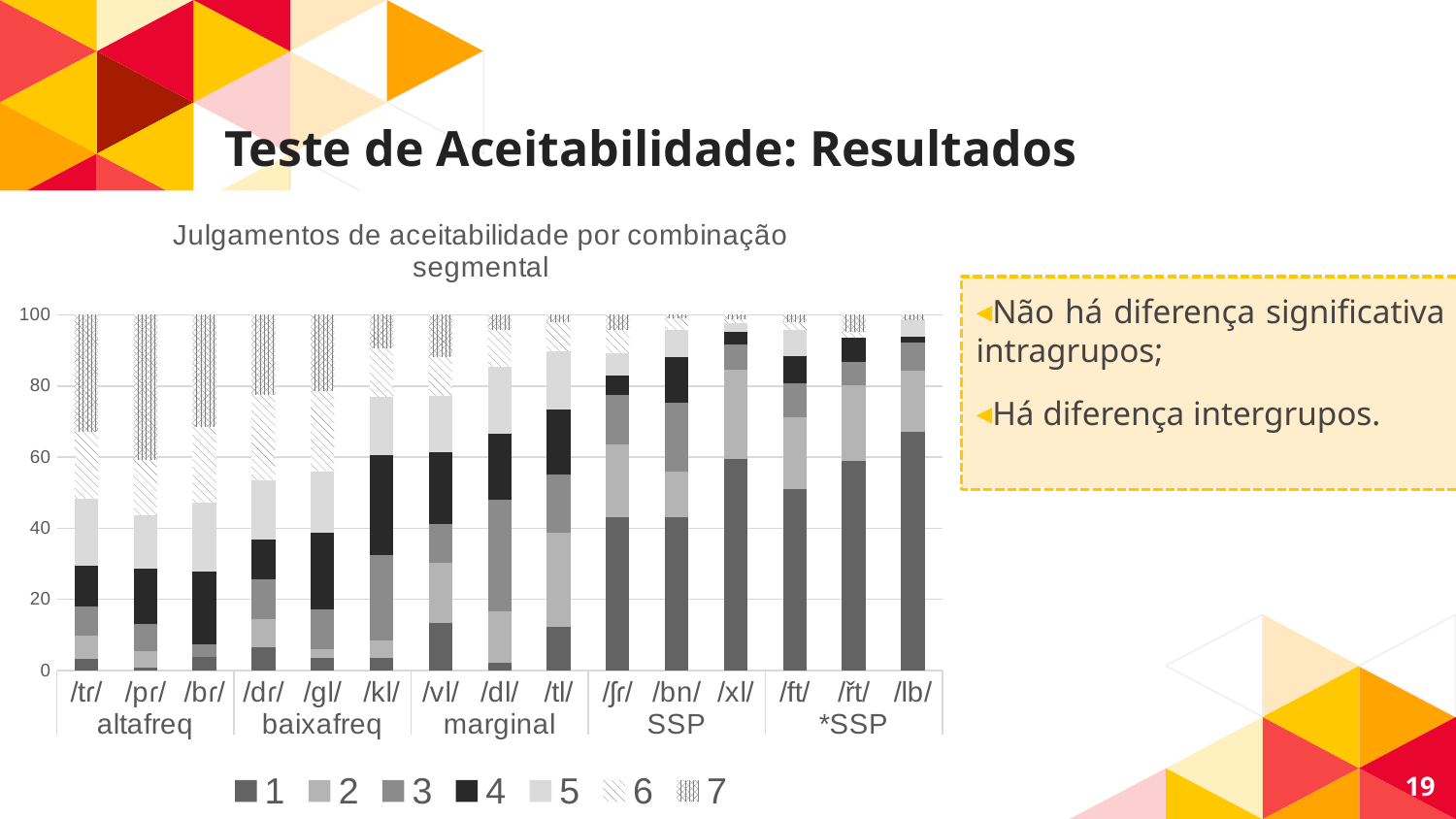
Is the value of series 1 for /lb/ greater or less than 60? greater Which has a larger segment for series 7, /tr/ or /lb/? /tr/ What is the title of the chart? Julgamentos de aceitabilidade por combinação segmental What are the names of the five groups on the x axis? altafreq, baixafreq, marginal, SSP, *SSP How many series does the legend list? 7 Which bar has the largest segment for series 1? /lb/ Which has a larger segment for series 1, /lb/ or /tr/? /lb/ What kind of chart is shown on the slide? stacked bar chart Is the value of series 1 for /tr/ greater or less than 20? less How many groups are the bars divided into along the x axis? 5 How many segmental combinations (bars) are plotted on the x axis? 15 Is the value of series 1 for /xl/ greater or less than 40? greater